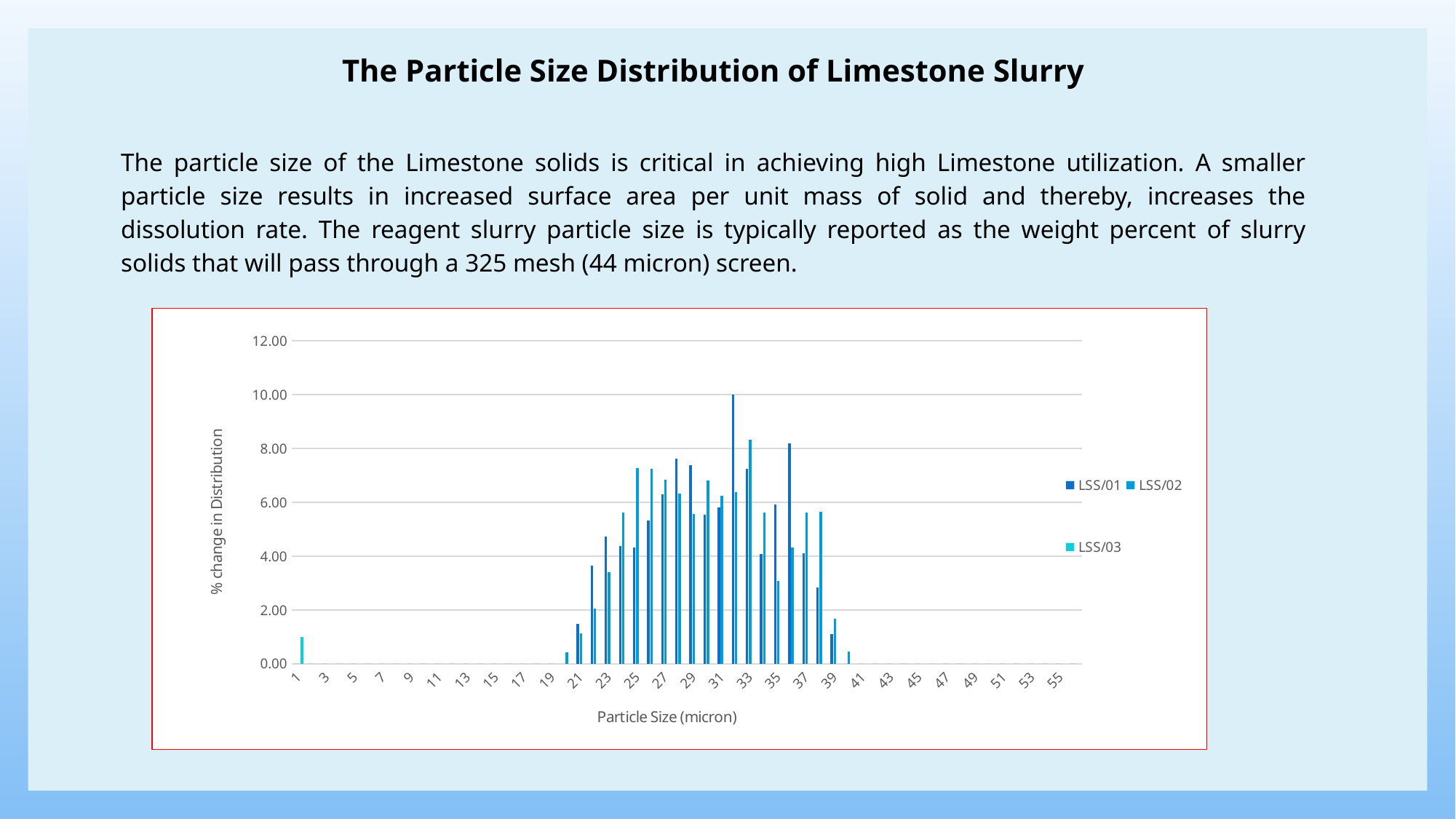
Is the LSS/02 bar at particle size 40 greater or less than 2.00? less Is the LSS/01 bar at particle size 28 greater or less than 6.00? greater What are the series names listed in the chart legend? LSS/01, LSS/02, LSS/03 How many series does the chart legend list? 3 Which is larger: the LSS/02 bar at particle size 32 or the LSS/01 bar at particle size 28? LSS/01 at particle size 28 What kind of chart is shown on the slide? bar chart Which series has a bar only at particle size 1? LSS/03 Is the value for LSS/03 at particle size 1 greater or less than 2.00? less What is the title of the vertical axis of the chart? % change in Distribution Which series has the tallest bar in the chart? LSS/01 What is the highest value shown on the vertical axis of the chart? 12.00